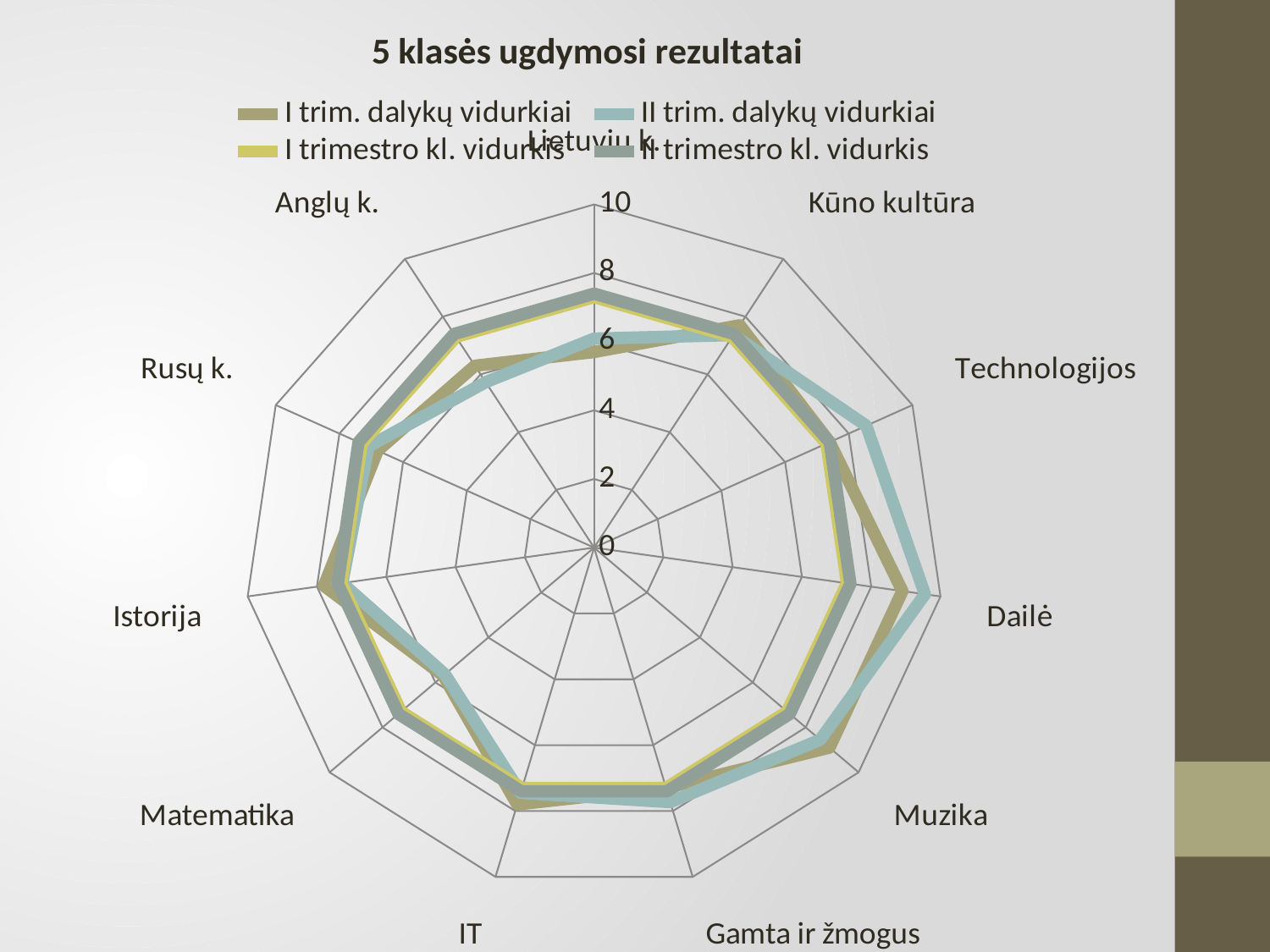
What is the maximum value shown on the chart's axis scale? 10 Is the value for Lietuvių k. in the I trim. dalykų vidurkiai series greater or less than 8? less Which subject has the highest value in the II trim. dalykų vidurkiai series? Dailė Is the value for Dailė in the II trim. dalykų vidurkiai series greater or less than 8? greater Is the value for Anglų k. in the I trim. dalykų vidurkiai series greater or less than 4? greater How many subject categories are plotted on the radar chart? 11 How many series does the legend list? 4 What is the title of the chart? 5 klasės ugdymosi rezultatai What kind of chart is shown on the slide? radar chart